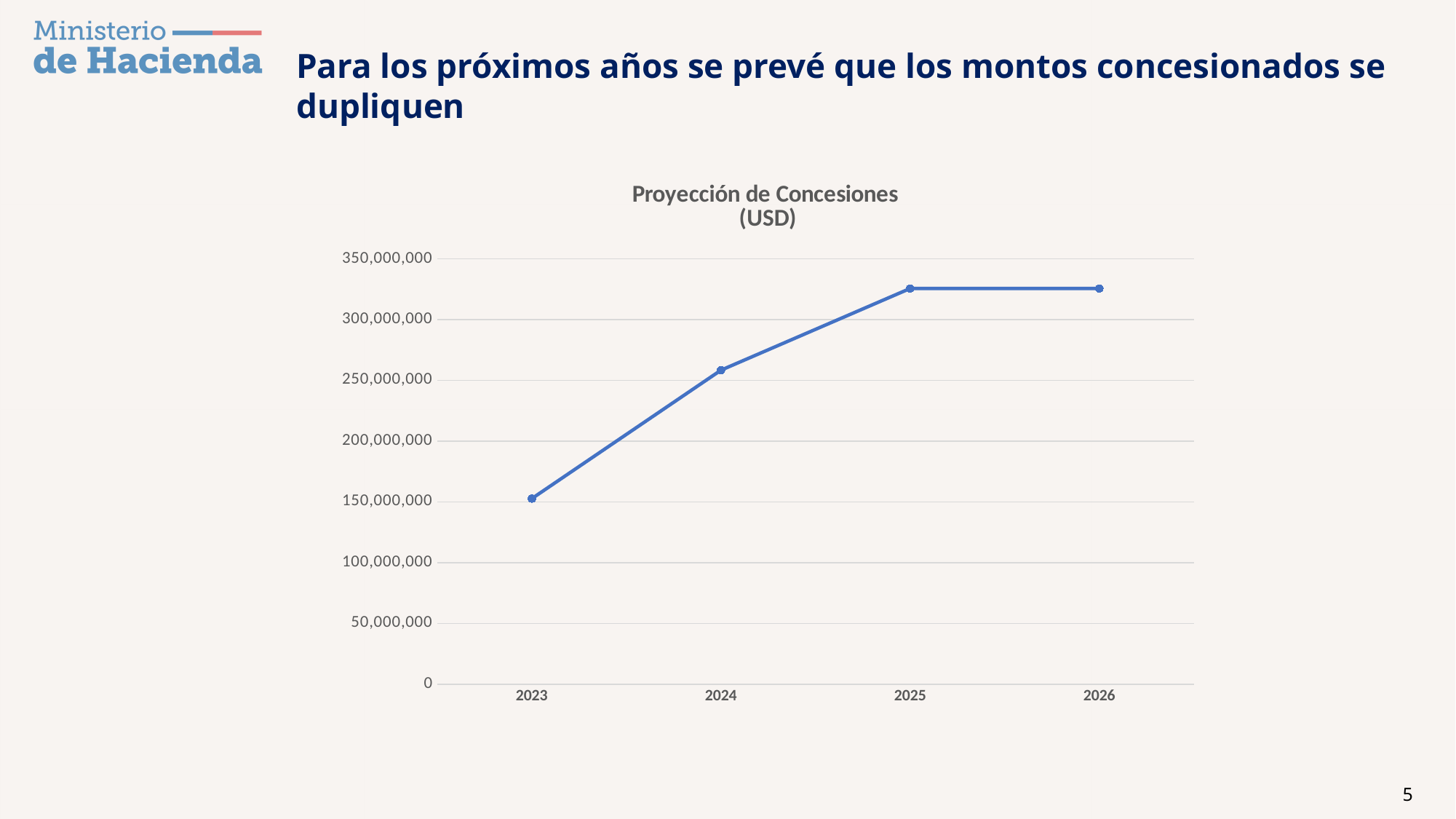
Which year has the lowest projected value in the chart? 2023 Do the values rise or fall from 2023 to 2025? rise Is the value for 2026 greater or less than 350,000,000? less What is the highest value shown on the vertical axis of the chart? 350,000,000 Is the value for 2025 greater or less than 300,000,000? greater What is the title of the chart? Proyección de Concesiones (USD) Is the value for 2023 greater or less than 200,000,000? less Which year has the larger value, 2023 or 2024? 2024 What kind of chart is shown on the slide? line chart How many years are plotted on the x axis of the chart? 4